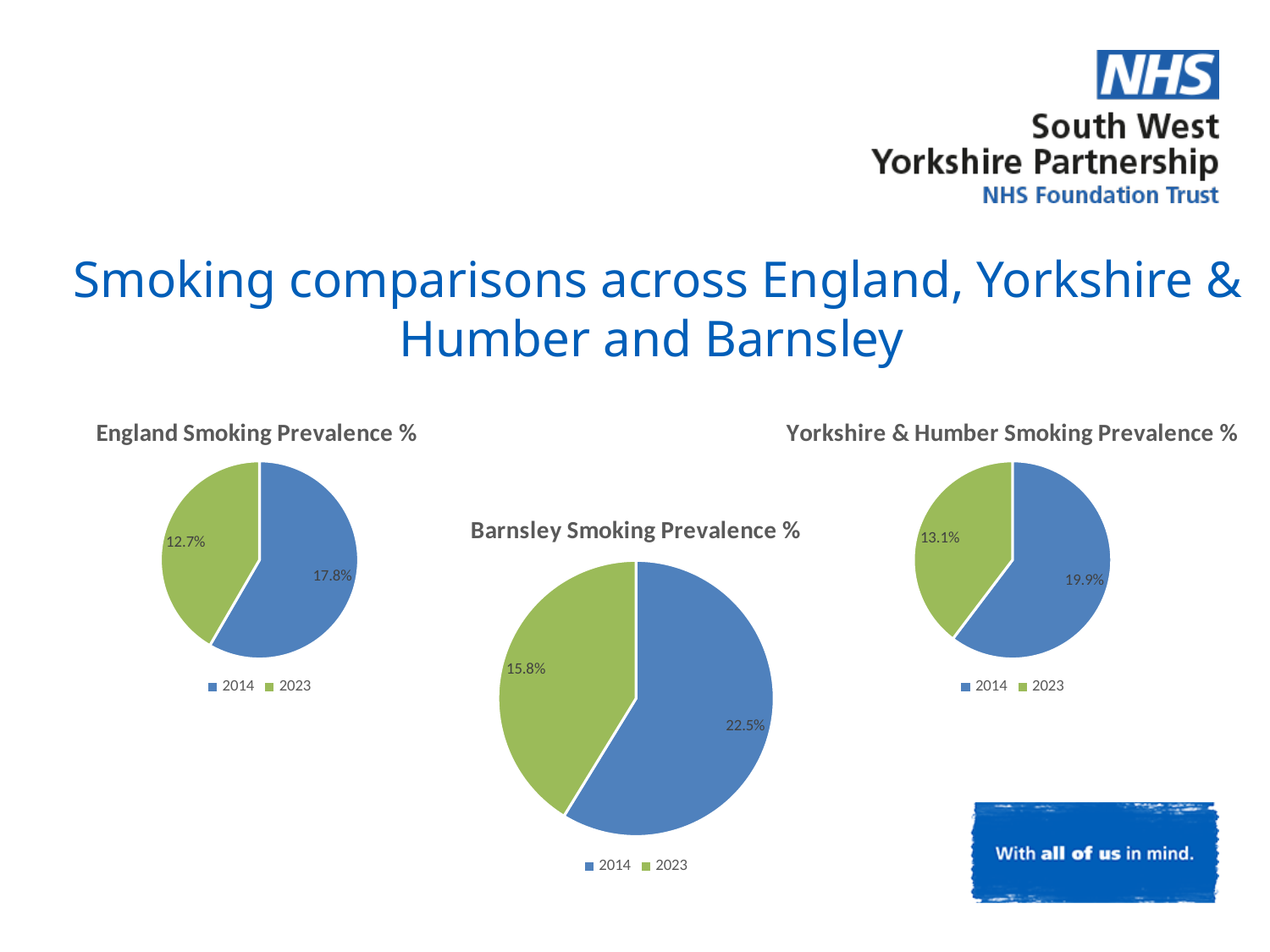
What kind of chart is the Barnsley Smoking Prevalence % chart? Pie chart In the England Smoking Prevalence % chart, what is the value for 2023? 12.7% In the Barnsley Smoking Prevalence % chart, what is the difference between the 2014 and 2023 values? 6.7% How many slices does the England Smoking Prevalence % pie chart have? 2 In the Yorkshire & Humber Smoking Prevalence % chart, what is the value for 2014? 19.9% In the Barnsley Smoking Prevalence % chart, which colour represents 2023? Green In the Yorkshire & Humber Smoking Prevalence % chart, what is the value for 2023? 13.1% In the England Smoking Prevalence % chart, what is the difference between the 2014 and 2023 values? 5.1% In the Barnsley Smoking Prevalence % chart, what is the value for 2023? 15.8% In the England Smoking Prevalence % chart, what is the value for 2014? 17.8% In the Yorkshire & Humber Smoking Prevalence % chart, which slice is larger, 2014 or 2023? 2014 In the Barnsley Smoking Prevalence % chart, what is the value for 2014? 22.5%